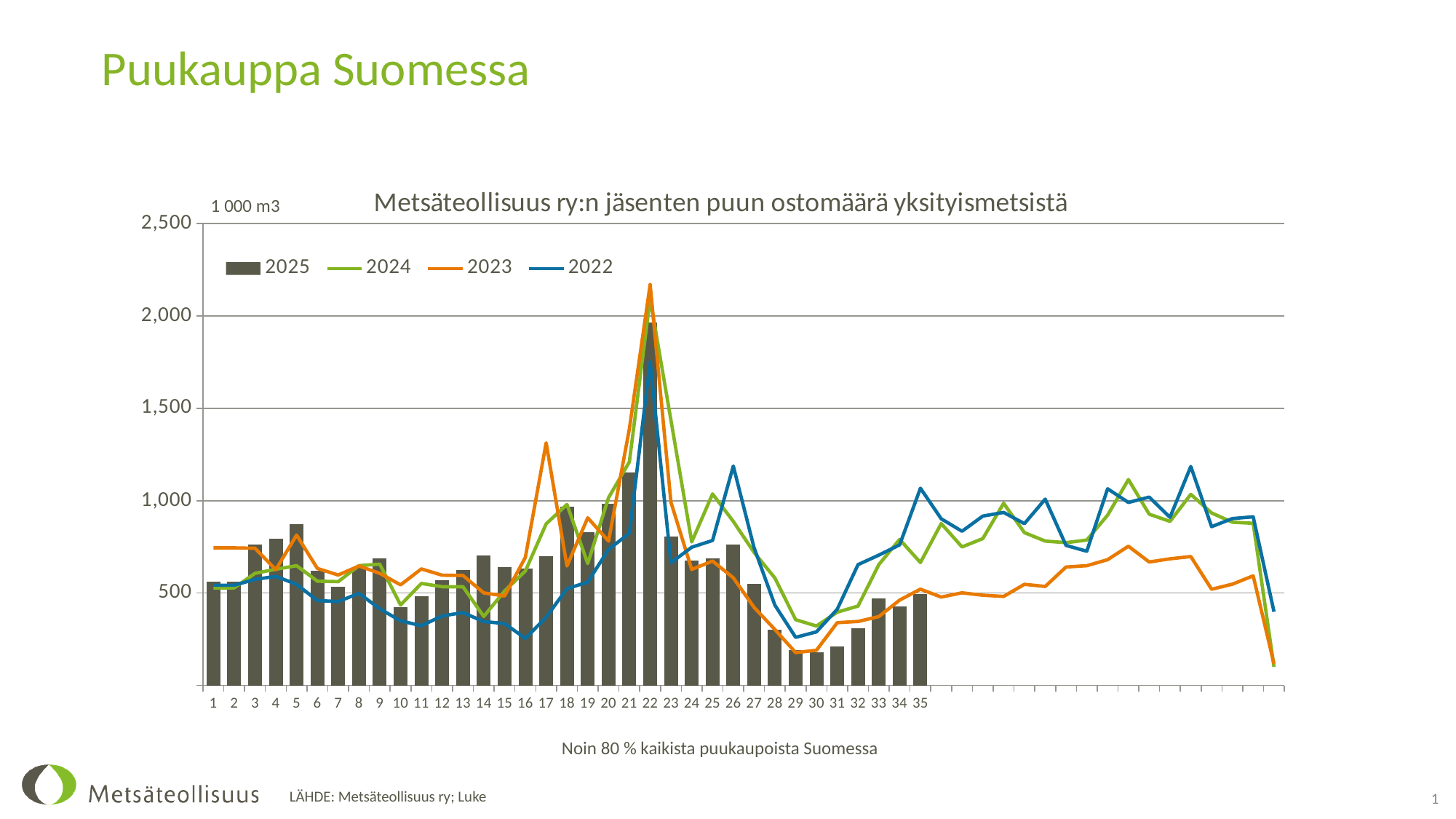
Is the 2025 bar for week 22 greater or less than 1,500? greater Is the 2025 bar for week 21 greater or less than 1,000? greater What kind of chart is shown on the slide? A combined bar and line chart How many weeks have a bar plotted for the 2025 series? 35 In which week is the 2025 bar the highest? 22 Is the 2025 bar for week 29 greater or less than 500? less How many series does the legend list? 4 Do the 2025 bars rise or fall from week 22 to week 29? Fall Which is larger, the 2025 bar for week 5 or the 2025 bar for week 10? Week 5 Which series is drawn as bars rather than a line? 2025